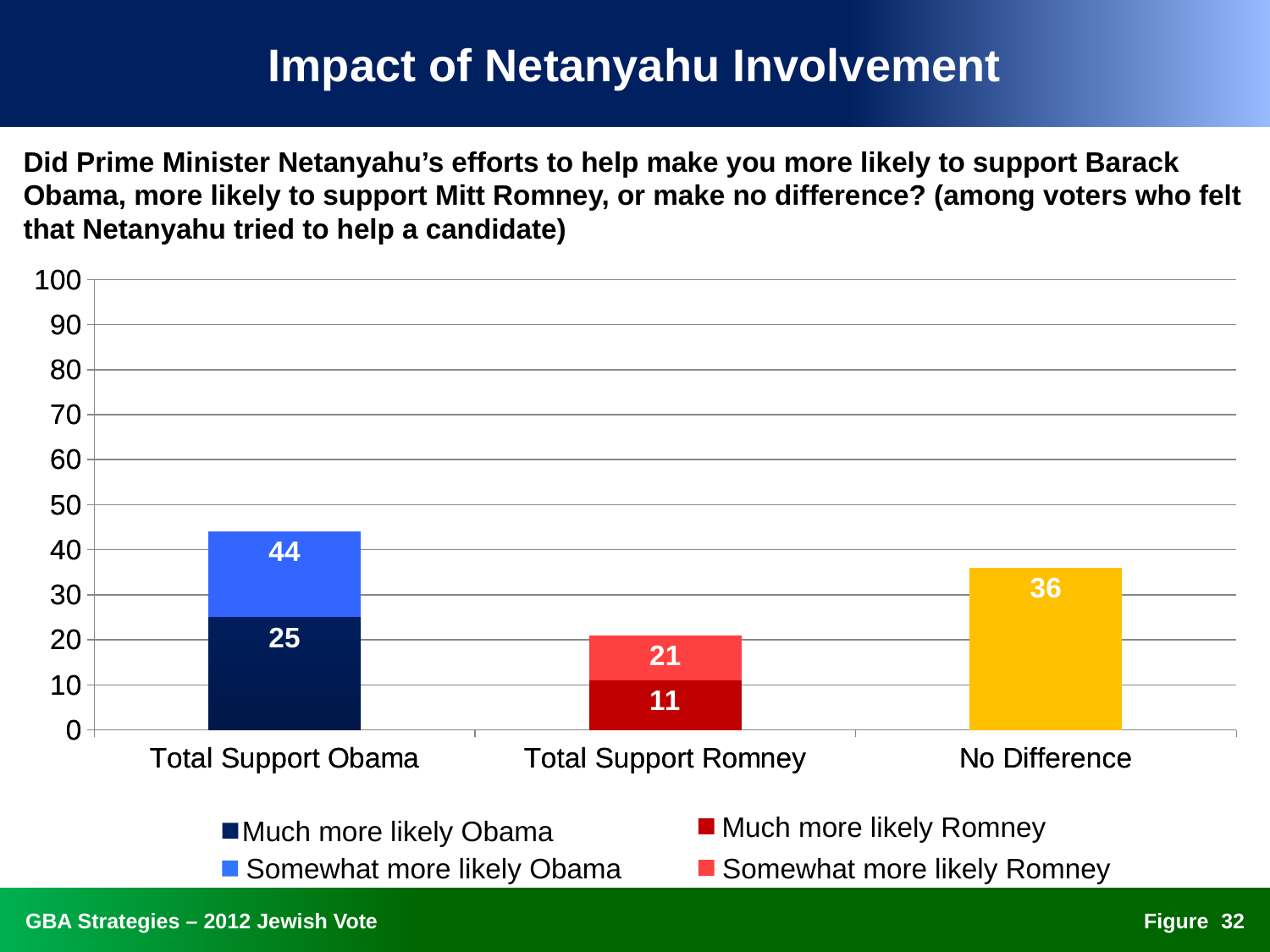
What is the value of the Much more likely Romney segment in the Total Support Romney bar? 11 What is the value for No Difference? 36 What is the total height of the Total Support Romney bar? 21 What kind of chart is shown on the slide? Stacked bar chart How many categories are shown on the x axis of the chart? 3 Which category has the tallest bar? Total Support Obama How many series does the chart's legend list? 4 What is the value of the Much more likely Obama segment in the Total Support Obama bar? 25 Which is larger: the Much more likely Obama segment or the Much more likely Romney segment? Much more likely Obama Which category has the shortest bar? Total Support Romney What is the difference between the total for Total Support Obama and the total for Total Support Romney? 23 What is the total height of the Total Support Obama bar? 44